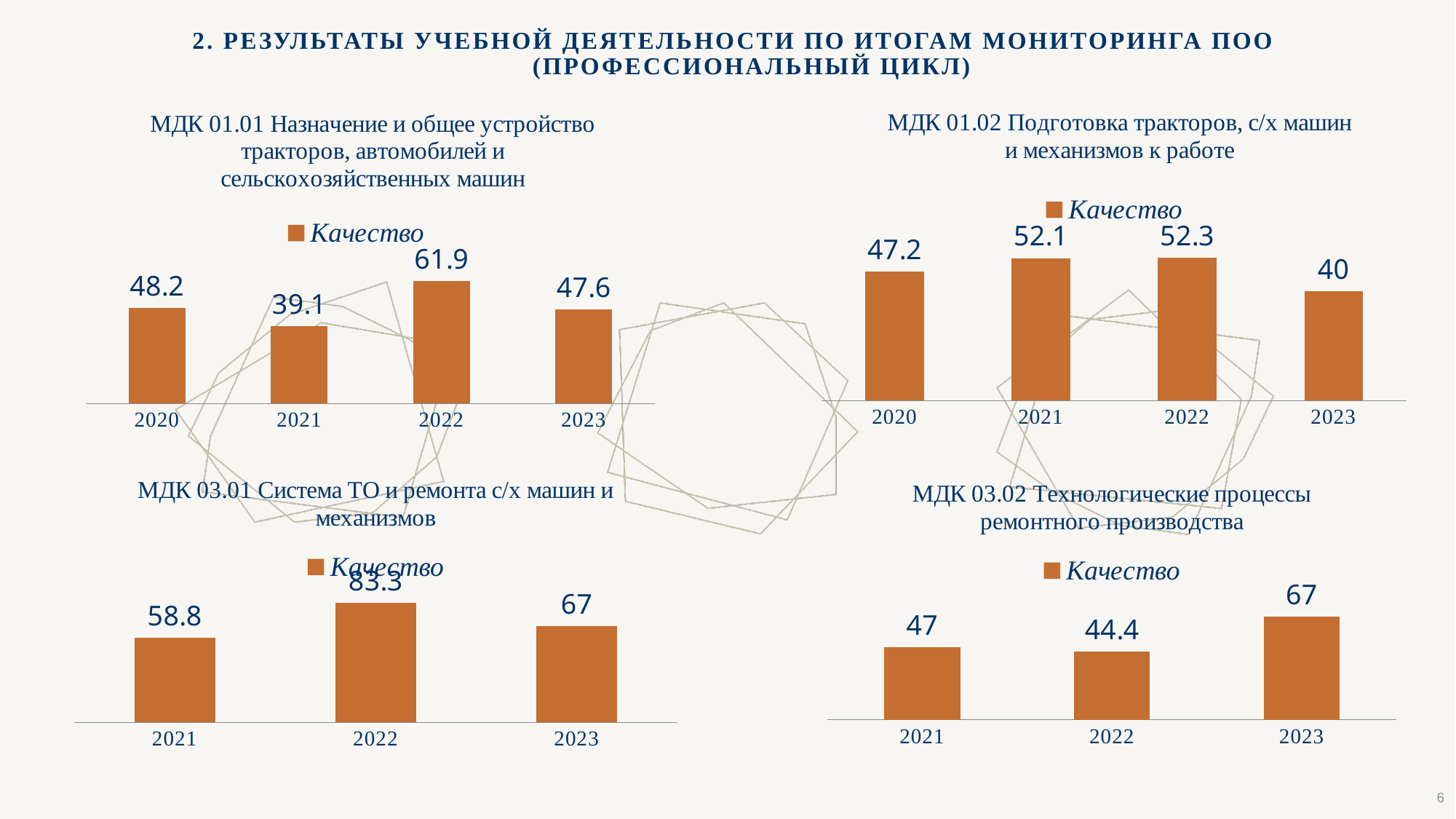
In the top-right chart (МДК 01.02), which year has the lowest value? 2023 In the bottom-left chart (МДК 03.01), which year has the highest value? 2022 What series name is shown in the legend of the top-left chart (МДК 01.01)? Качество In the top-right chart (МДК 01.02), what is the value for 2020? 47.2 In the top-left chart (МДК 01.01), which year has the lowest value? 2021 In the top-left chart (МДК 01.01), what is the value for 2022? 61.9 In the bottom-left chart (МДК 03.01), what is the value for 2021? 58.8 In the bottom-right chart (МДК 03.02), what is the difference between the 2023 and 2022 values? 22.6 What type of chart is the bottom-right chart (МДК 03.02)? Bar chart In the top-left chart (МДК 01.01), what is the difference between the 2022 and 2021 values? 22.8 In the bottom-right chart (МДК 03.02), which is larger, the value for 2021 or the value for 2022? 2021 In the top-right chart (МДК 01.02), how many years are shown on the x axis? 4